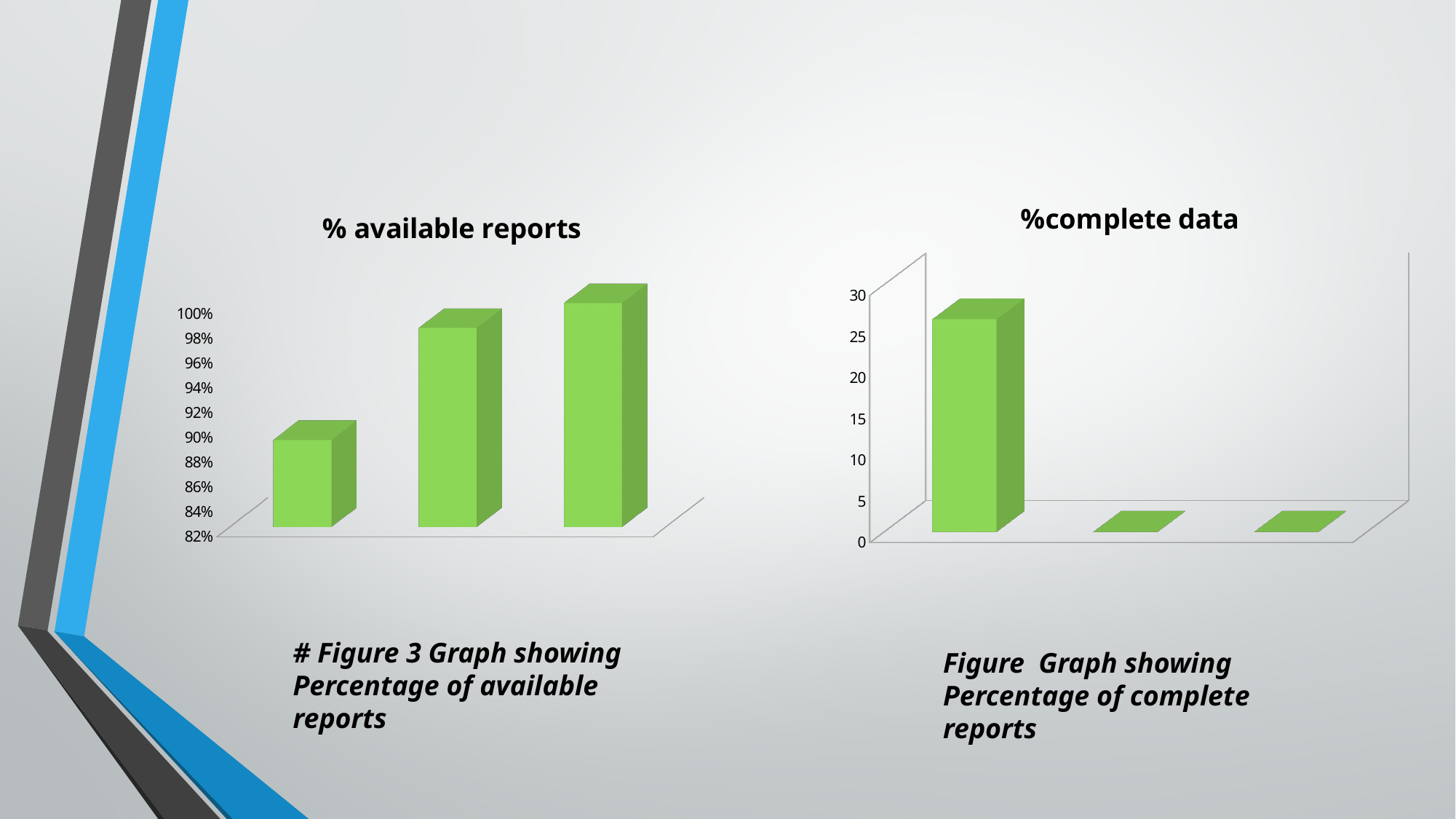
In the "% available reports" chart, do the values rise or fall from left to right? rise In the "% available reports" chart, is the value of the first bar greater or less than 94%? less What is the title of the chart on the right side of the slide? %complete data In the "%complete data" chart, is the value of the first bar greater or less than 20? greater How many bars are plotted in the "% available reports" chart? 3 In the "%complete data" chart, which bar is the tallest? the first bar In the "%complete data" chart, is the value of the second bar greater or less than 5? less In the "% available reports" chart, which bar is the shortest? the first bar In the "% available reports" chart, which bar is the tallest? the third bar What kind of chart is the "% available reports" chart? bar chart How many bars are plotted in the "%complete data" chart? 3